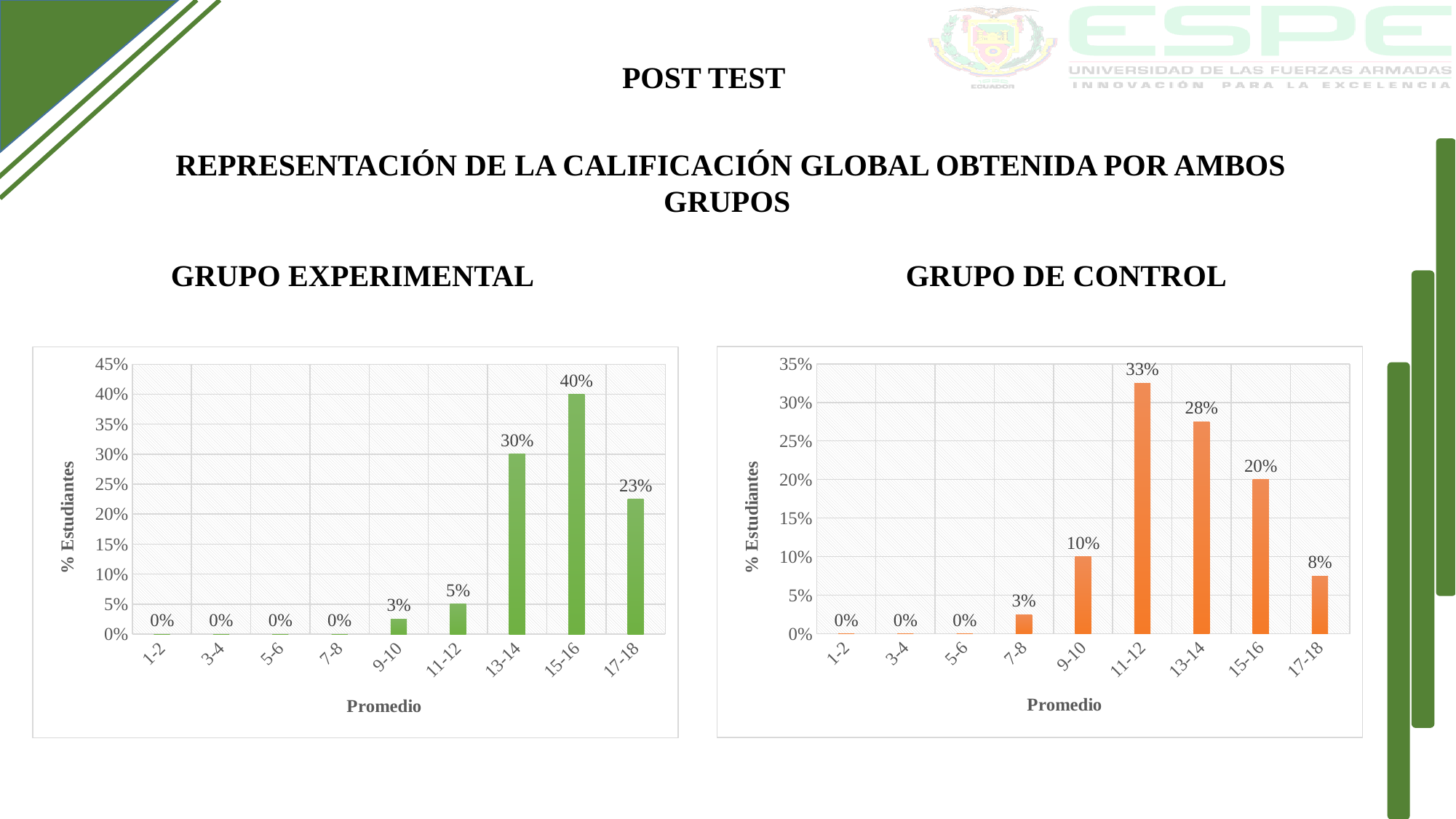
What kind of chart is the Grupo de Control chart? Bar chart What is the x-axis title of the Grupo Experimental chart? Promedio In the Grupo Experimental chart, what is the difference between the values for 15-16 and 13-14? 10% In the Grupo de Control chart, what is the difference between the values for 13-14 and 15-16? 8% In the Grupo Experimental chart, what is the value for the 15-16 category? 40% In the Grupo de Control chart, what is the value for the 9-10 category? 10% In the Grupo de Control chart, what is the value for the 11-12 category? 33% In the Grupo Experimental chart, which category has the highest value? 15-16 In the Grupo de Control chart, which is larger, the value for 13-14 or the value for 17-18? 13-14 In the Grupo de Control chart, which category has the highest value? 11-12 In the Grupo Experimental chart, what is the value for the 17-18 category? 23% How many categories are shown on the x axis of the Grupo Experimental chart? 9